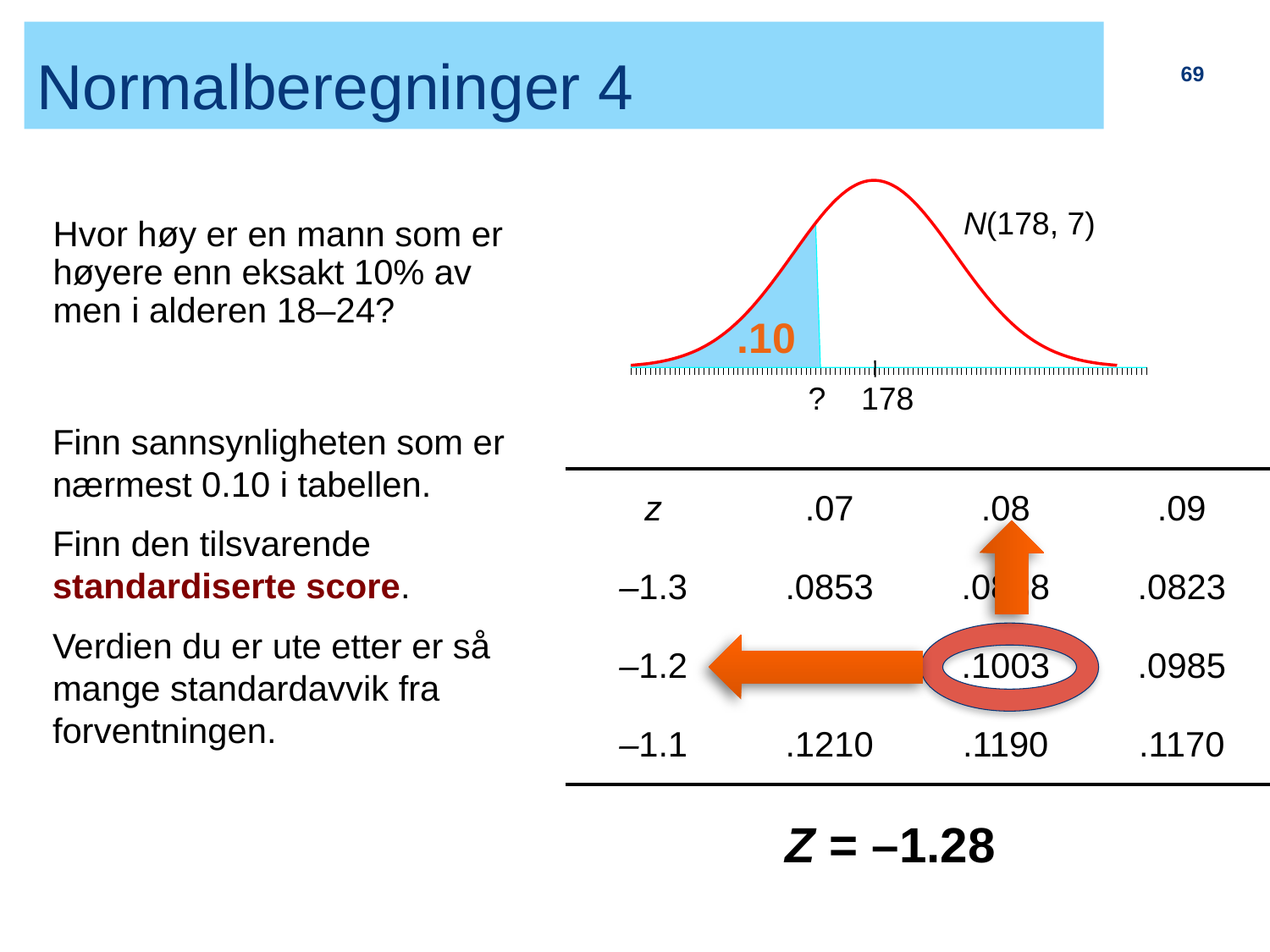
What is the final standardised score Z given at the bottom of the slide? Z = –1.28 In the table, what value is in the row z = –1.3 and column .07? .0853 In the table, what value is in the row z = –1.2 and column .08? .1003 What distribution is labelled next to the normal curve? N(178, 7) In the table, what value is in the row z = –1.1 and column .09? .1170 Is the shaded area under the curve to the left or to the right of 178? left Which table value is circled? .1003 What probability is printed inside the shaded area under the normal curve? .10 What value is marked at the centre of the horizontal axis of the normal curve? 178 How many z rows does the table show? 3 What kind of chart is shown at the top right of the slide? a normal distribution curve (line chart)